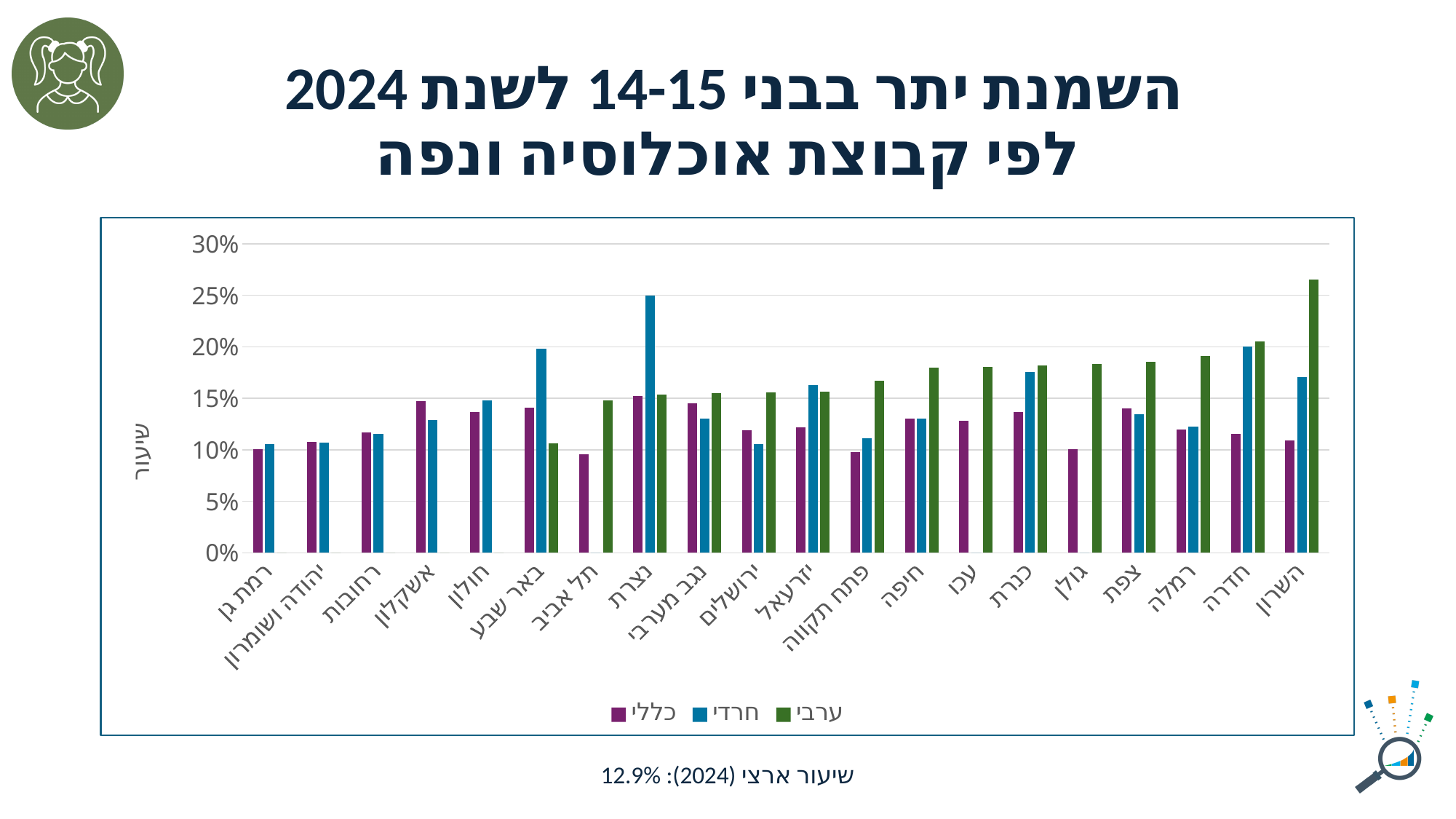
Is the ערבי value for השרון greater or less than 25%? greater In באר שבע, which is larger: the חרדי value or the ערבי value? חרדי In נצרת, which is larger: the חרדי value or the כללי value? חרדי Which district has the highest ערבי value? השרון What are the three legend entries of the chart? כללי, חרדי, ערבי Is the חרדי value for באר שבע greater or less than 15%? greater What kind of chart is shown on the slide? bar chart How many series does the legend list? 3 How many districts (categories) are shown on the x axis? 20 Which district has the highest חרדי value? נצרת